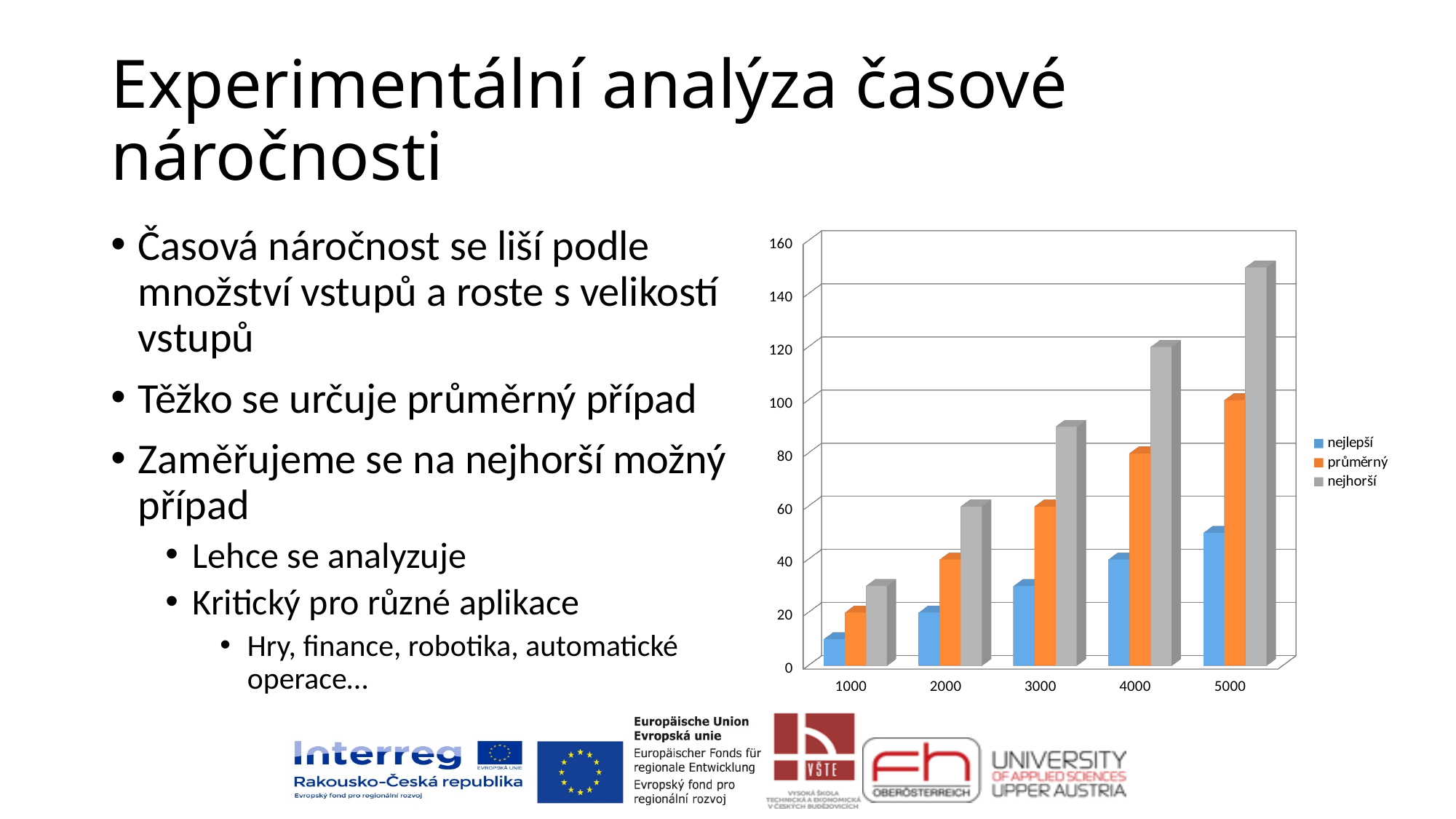
How many series does the legend list? 3 Is the value for nejhorší at 5000 greater or less than 140? greater Which series is shown in orange in the legend? průměrný How many categories are shown on the x axis? 5 Which category has the lowest value for the nejlepší series? 1000 Is the value for nejlepší at 1000 greater or less than 20? less What kind of chart is shown on the slide? bar chart Is the value for nejhorší at 2000 greater or less than 80? less Which series is shown in grey in the legend? nejhorší Which category has the highest value for the nejhorší series? 5000 Do the values for the průměrný series rise or fall as the x axis goes from 1000 to 5000? rise